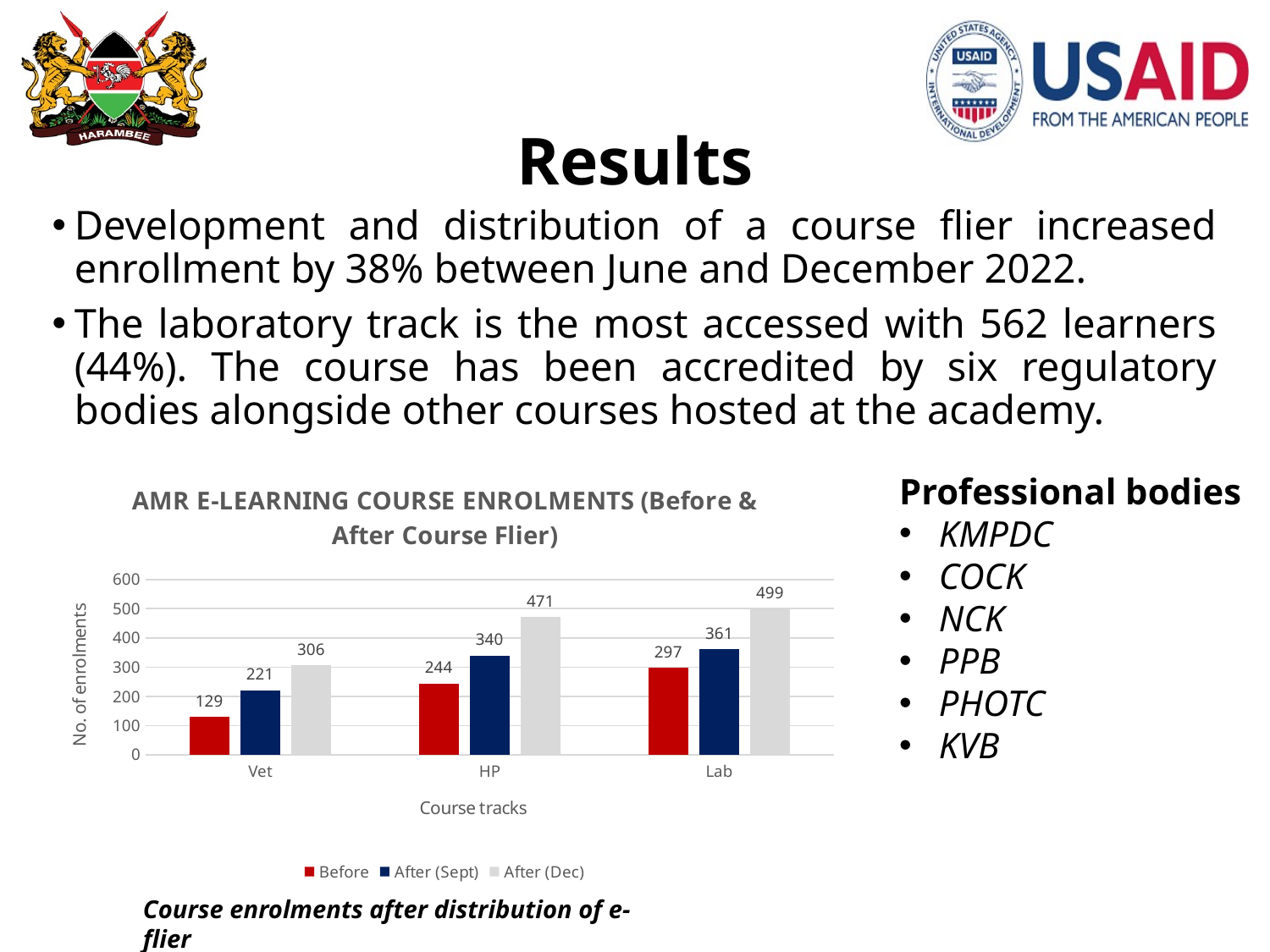
What is the label of the y axis of the chart? No. of enrolments Which is larger: the 'After (Sept)' value for HP or the 'Before' value for Lab? After (Sept) for HP What is the 'After (Dec)' enrolment value for the HP course track? 471 How many series does the chart legend list? 3 What is the difference between the 'After (Dec)' and 'Before' enrolments for the Lab course track? 202 For the Vet course track, do enrolments rise or fall from 'Before' to 'After (Dec)'? Rise Which course track has the lowest 'Before' enrolment? Vet How many course tracks are shown on the x axis of the chart? 3 Which course track has the highest 'After (Dec)' enrolment? Lab What is the 'After (Sept)' enrolment value for the Lab course track? 361 What kind of chart is used to show the AMR e-learning course enrolments? Bar chart What is the 'Before' enrolment value for the Vet course track? 129